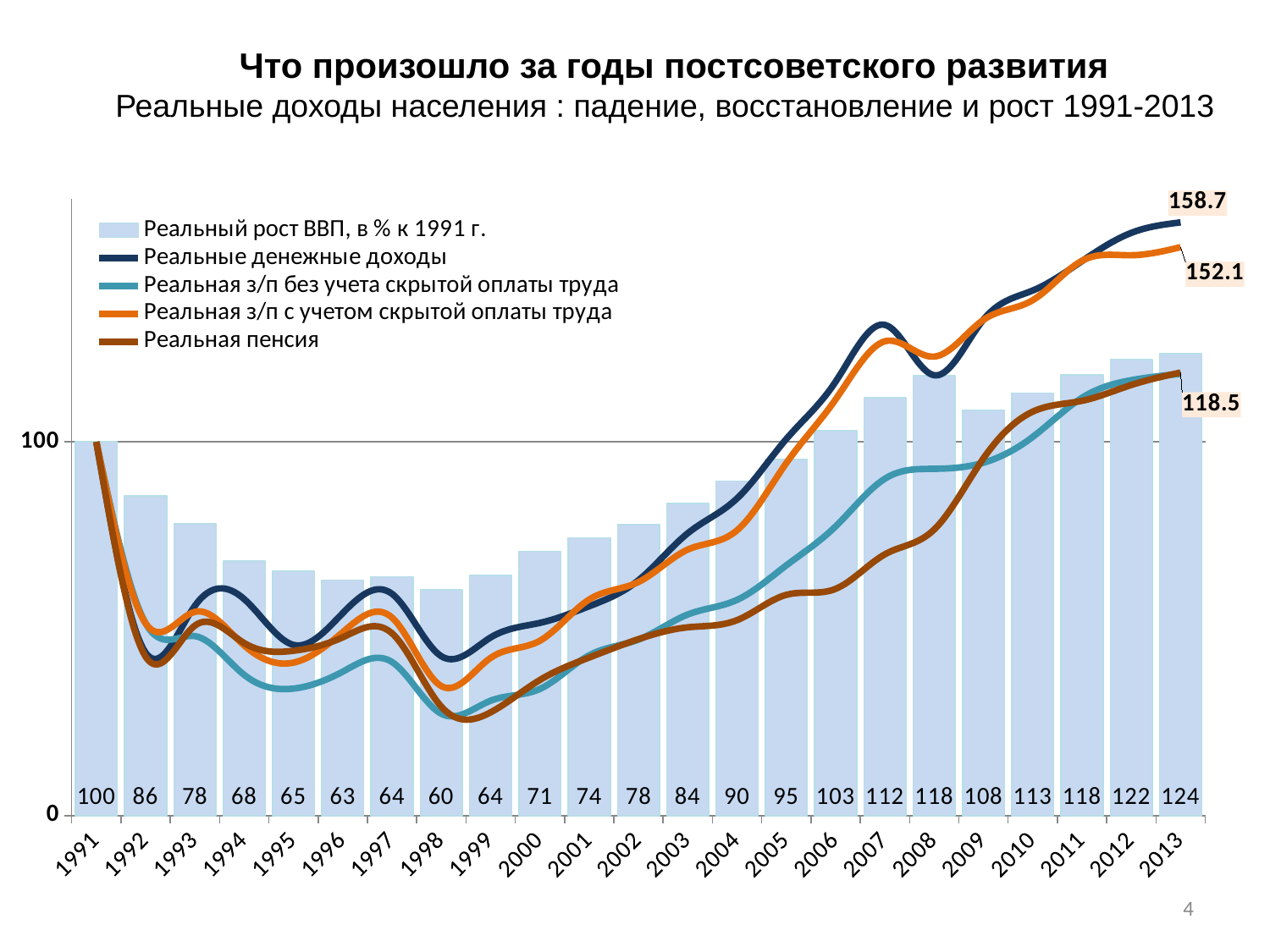
What value is labelled for Реальная пенсия at the end of the series in 2013? 118.5 How many years are shown on the x axis? 23 What is the difference between the bar values for 2013 and 1991? 24 What value is labelled for Реальные денежные доходы at the end of the series in 2013? 158.7 Which year has the lowest bar value for Реальный рост ВВП? 1998 How many series does the legend list? 5 What is the value of the bar for 2008 (Реальный рост ВВП, в % к 1991 г.)? 118 Do the bar values for Реальный рост ВВП rise or fall from 1991 to 1998? fall Which is larger, the bar value for 2007 or the bar value for 2009? 2007 What is the value of the bar for 1998 (Реальный рост ВВП, в % к 1991 г.)? 60 Is the value of Реальная з/п без учета скрытой оплаты труда in 2005 greater or less than 100? less Which year has the highest bar value for Реальный рост ВВП? 2013